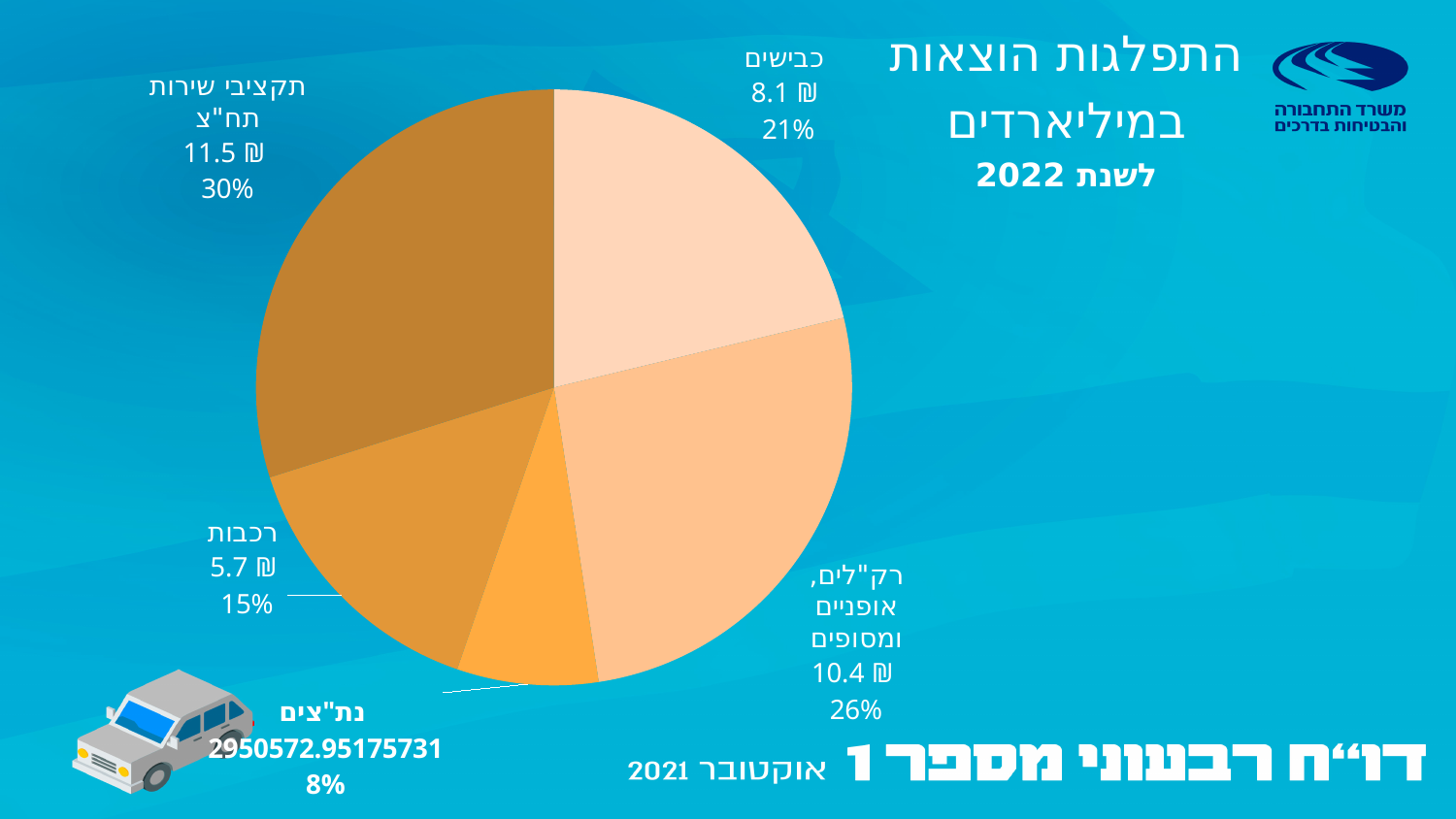
What percentage share does תקציבי שירות תח"צ have? 30% What year does the chart title say the expense distribution is for? 2022 What percentage share does רכבות have? 15% What kind of chart is shown on the slide? Pie chart What is the value shown for כבישים? ₪ 8.1 How many slices does the pie chart have? 5 Which category has the largest share of the pie? תקציבי שירות תח"צ Which category has the smallest share of the pie? נת"צים What percentage share does נת"צים have? 8% Which is larger, the value for רק"לים, אופניים ומסופים or the value for רכבות? רק"לים, אופניים ומסופים What is the difference in value between תקציבי שירות תח"צ and כבישים? ₪ 3.4 What is the value shown for רק"לים, אופניים ומסופים? ₪ 10.4